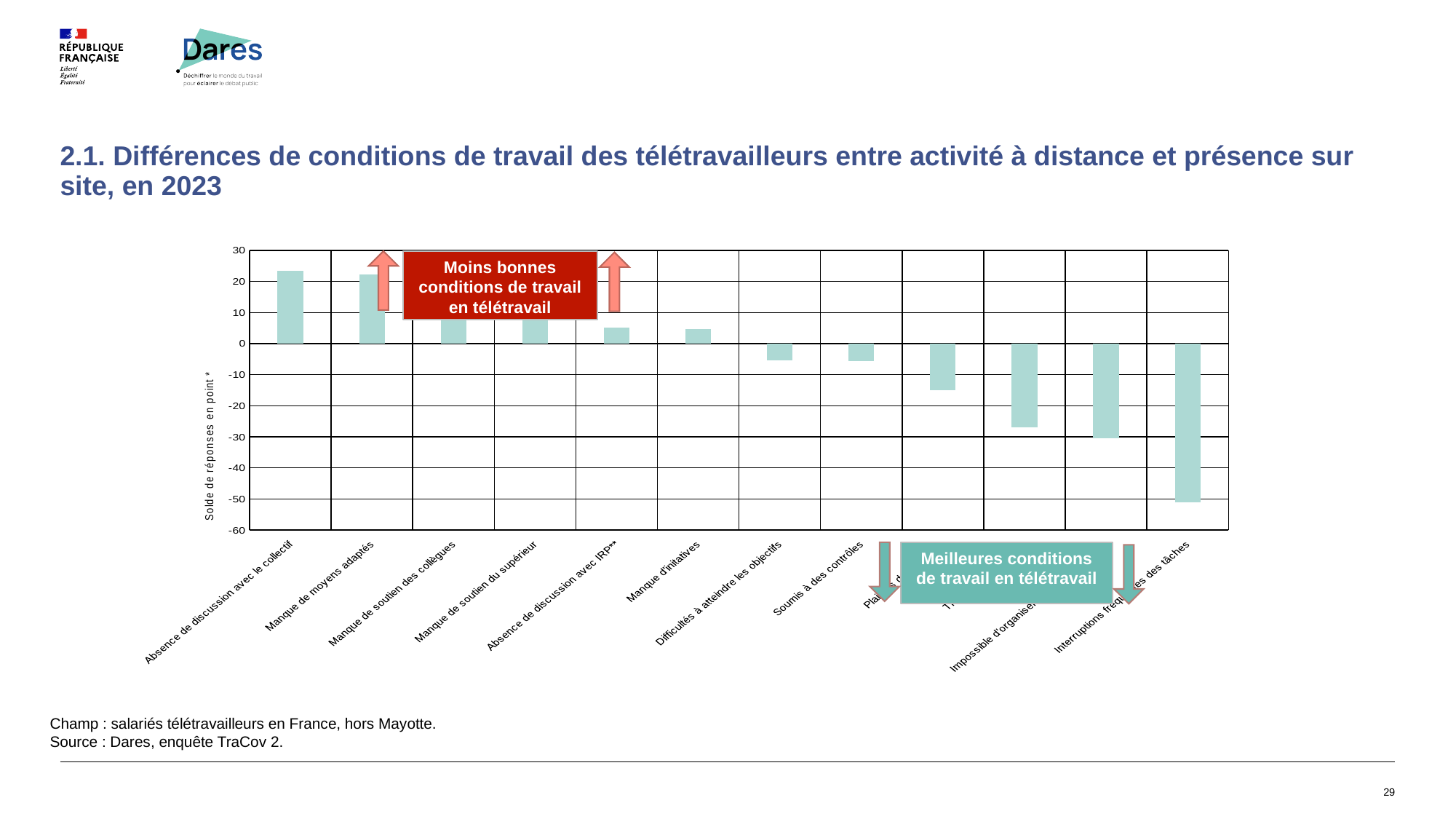
Which is larger, the value for 'Absence de discussion avec le collectif' or the value for 'Manque de soutien du supérieur'? Absence de discussion avec le collectif Is the value for 'Manque d'initiatives' greater or less than 0? greater How many bars are plotted in the chart? 12 What is the lowest value shown on the vertical axis? -60 Is the value for 'Manque de moyens adaptés' greater or less than 10? greater What kind of chart is shown on the slide? bar chart Is the value for 'Absence de discussion avec le collectif' greater or less than 20? greater What is the label of the vertical axis? Solde de réponses en point * Do the bar values rise or fall from left to right along the x axis? fall